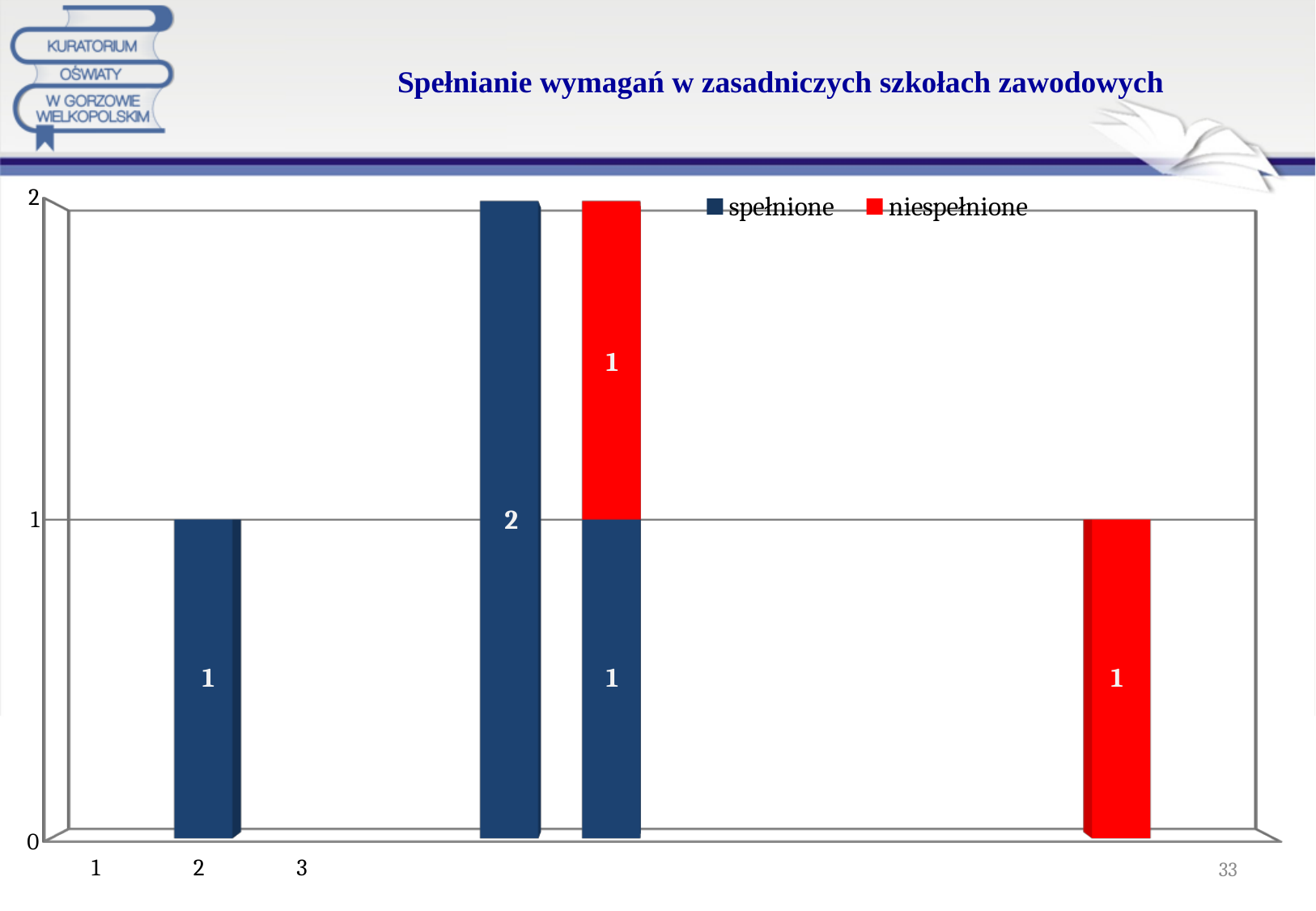
What kind of chart is shown on the slide? bar chart What is the title of the chart? Spełnianie wymagań w zasadniczych szkołach zawodowych What are the two series named in the legend? spełnione, niespełnione What is the value of spełnione for category 2? 1 What is the maximum value on the vertical axis? 2 What is the highest value shown for the niespełnione series? 1 What is the total of the stacked bar that contains both a spełnione and a niespełnione segment? 2 Is the value of spełnione for category 2 greater or less than 2? less What is the highest value shown for the spełnione series? 2 How many bars include a niespełnione segment? 2 How many series does the legend list? 2